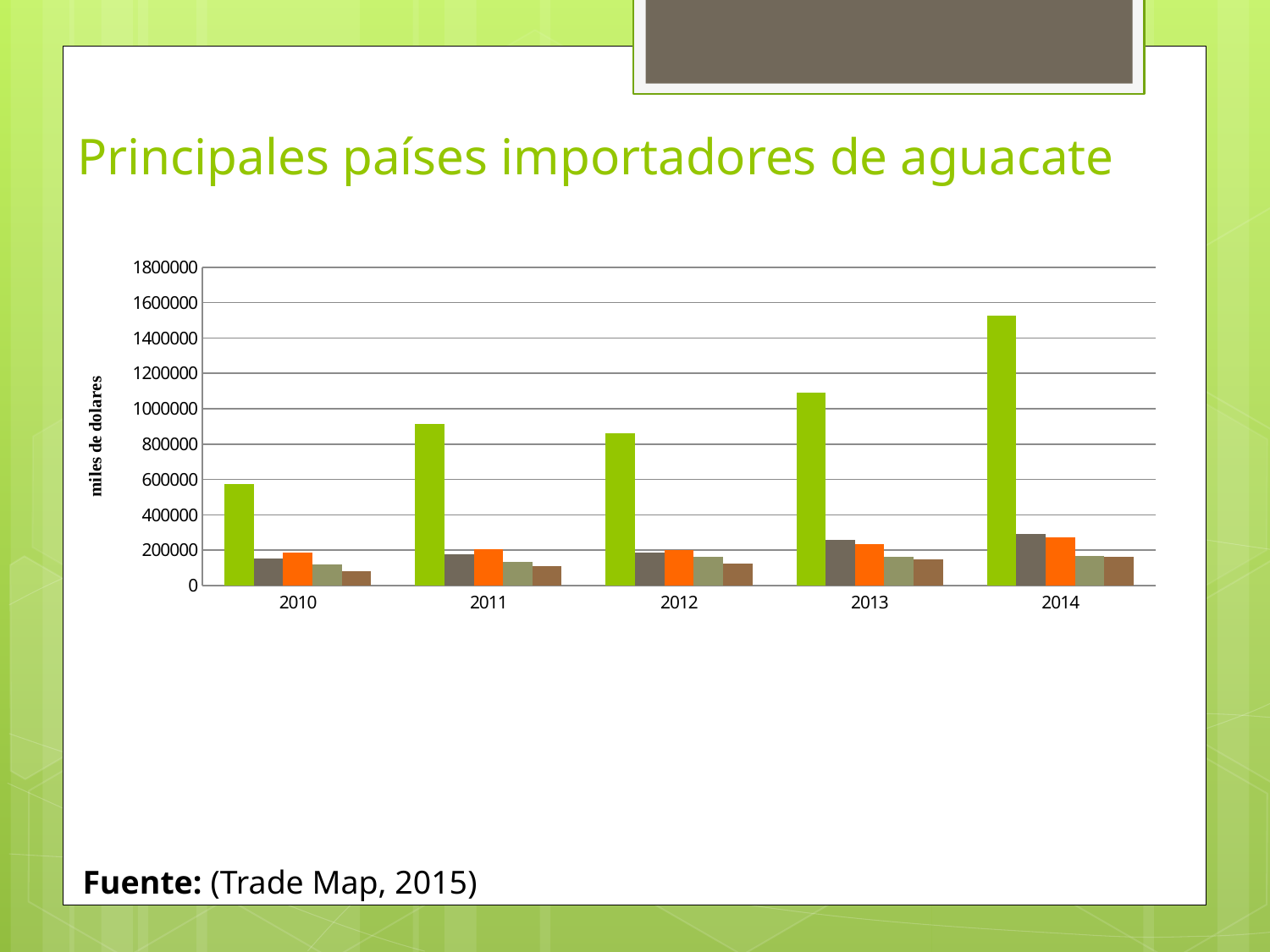
In which year is the green bar the shortest? 2010 Is the orange bar for 2014 greater or less than 200000? greater Is the green bar for 2010 greater or less than 400000? greater In which year is the green bar the tallest? 2014 How many years are shown on the x axis of the chart? 5 Is the green bar for 2014 greater or less than 1400000? greater Which is larger, the green bar for 2013 or the green bar for 2012? 2013 How many bars are plotted for each year in the chart? 5 What is the label on the vertical axis of the chart? miles de dolares What kind of chart is shown on the slide? bar chart